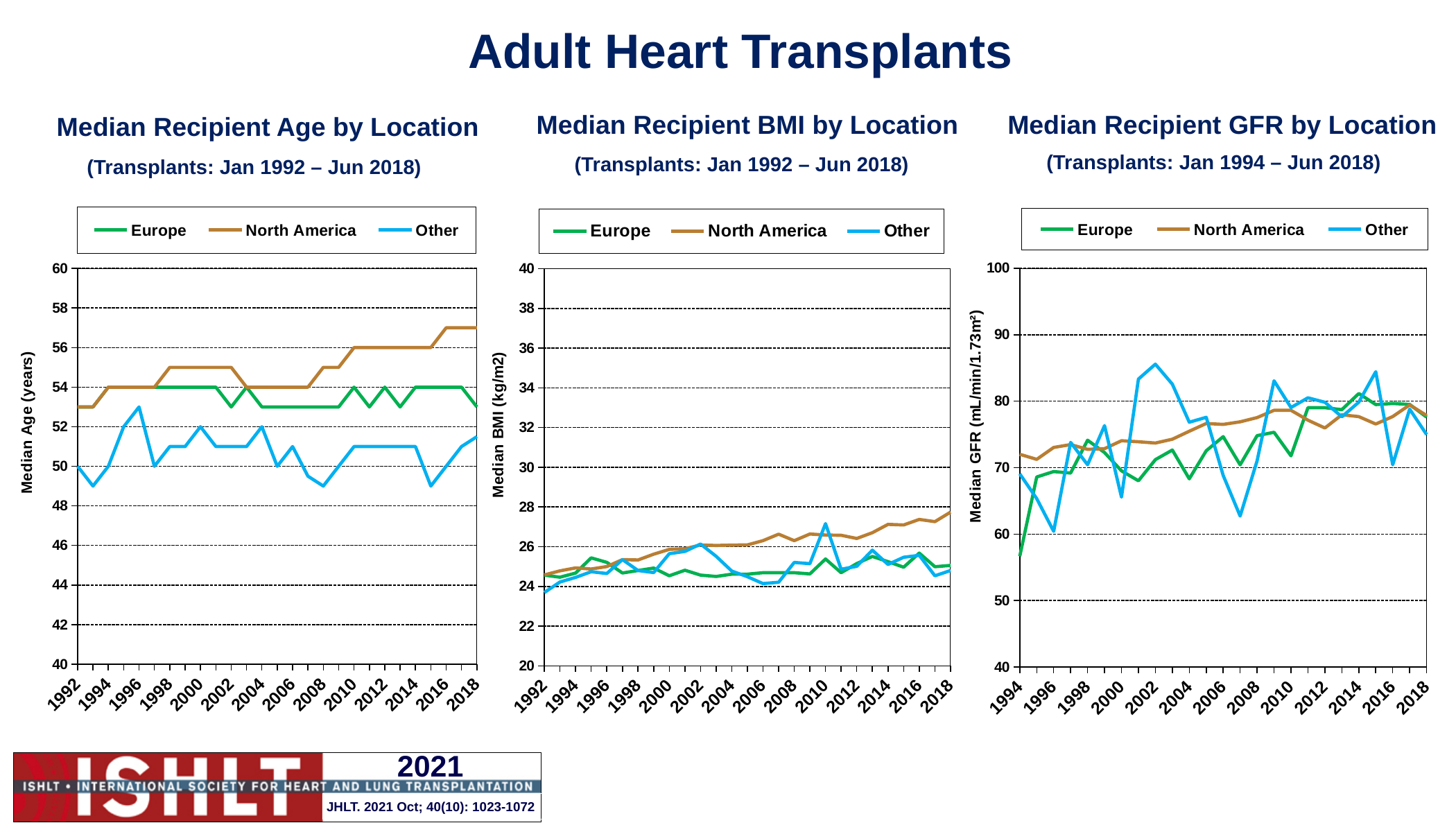
In the Median Recipient Age by Location chart, which series has the lowest value in 2018? Other In the Median Recipient BMI by Location chart, does the North America series rise or fall from 1992 to 2018? rise In the Median Recipient GFR by Location chart, which series has the highest value in 2003? Other In the Median Recipient Age by Location chart, what is the median age for North America in 2010? 56 In the Median Recipient Age by Location chart, what is the median age for Europe in 1998? 54 In the Median Recipient BMI by Location chart, is the value for North America in 2018 greater or less than 26? greater What type of chart is the Median Recipient Age by Location chart? line chart In the Median Recipient Age by Location chart, which is larger in 2018, North America or Europe? North America What is the y-axis label of the Median Recipient GFR by Location chart? Median GFR (mL/min/1.73m²) How many series does the legend of the Median Recipient BMI by Location chart list? 3 In the Median Recipient GFR by Location chart, is the value for Europe in 1994 greater or less than 60? less